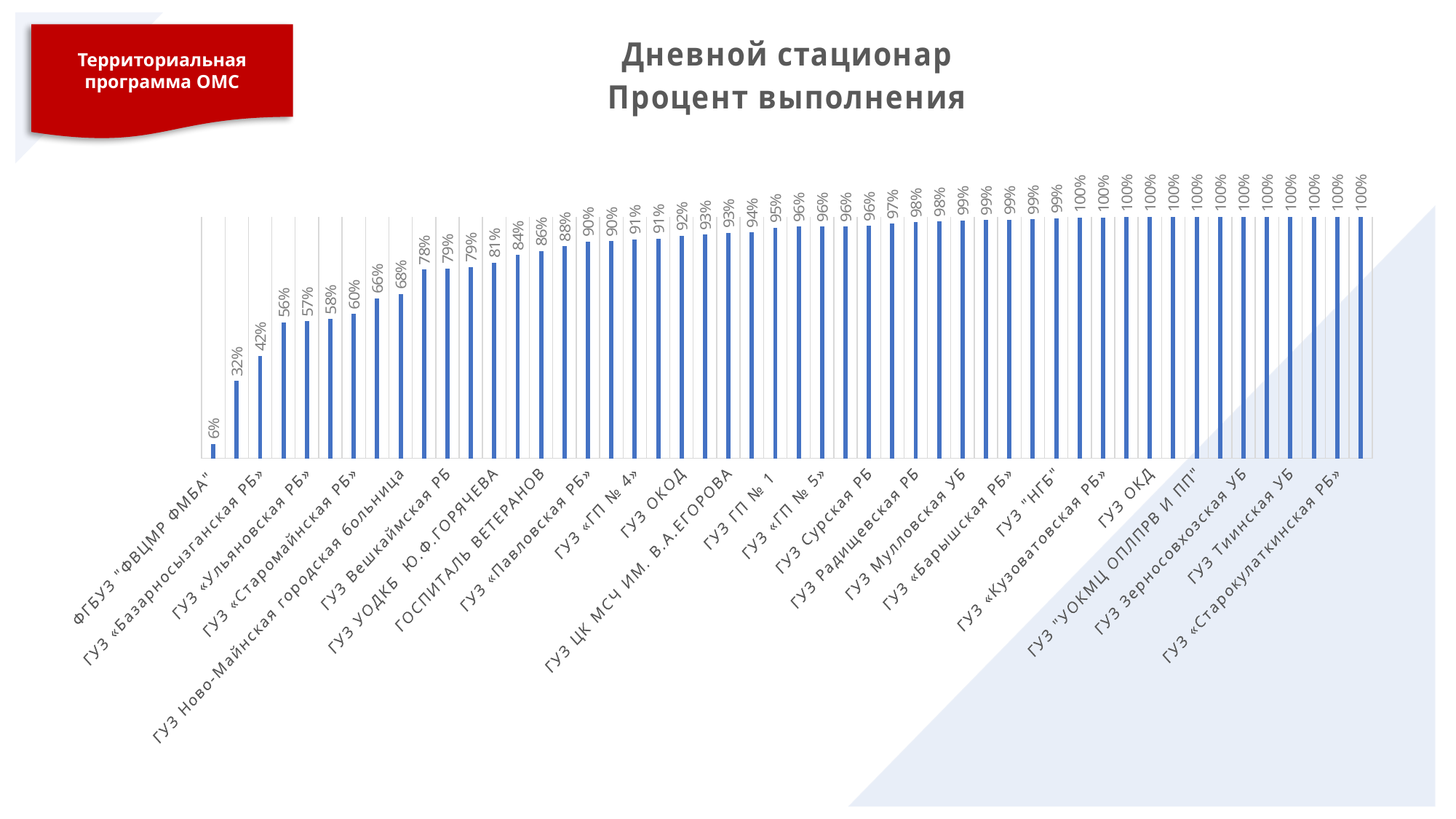
What is the value for ГУЗ «Павловская РБ»? 90% Which category has the lowest value? ФГБУЗ "ФВЦМР ФМБА" What type of chart is shown on the slide? bar chart Do the values rise or fall from left to right along the x axis? rise What is the highest value shown in the chart? 100% What is the difference between the values for ГУЗ «Павловская РБ» and ГУЗ «Базарносызганская РБ»? 48 percentage points What is the value for ФГБУЗ "ФВЦМР ФМБА"? 6% What is the value for ГУЗ «Базарносызганская РБ»? 42% What is the value for ГУЗ ОКОД? 92% What is the title of the chart? Дневной стационар Процент выполнения Which is larger, the value for ГУЗ «Базарносызганская РБ» or for ГУЗ «Павловская РБ»? ГУЗ «Павловская РБ» What is the value for ГУЗ «Старокулаткинская РБ»? 100%